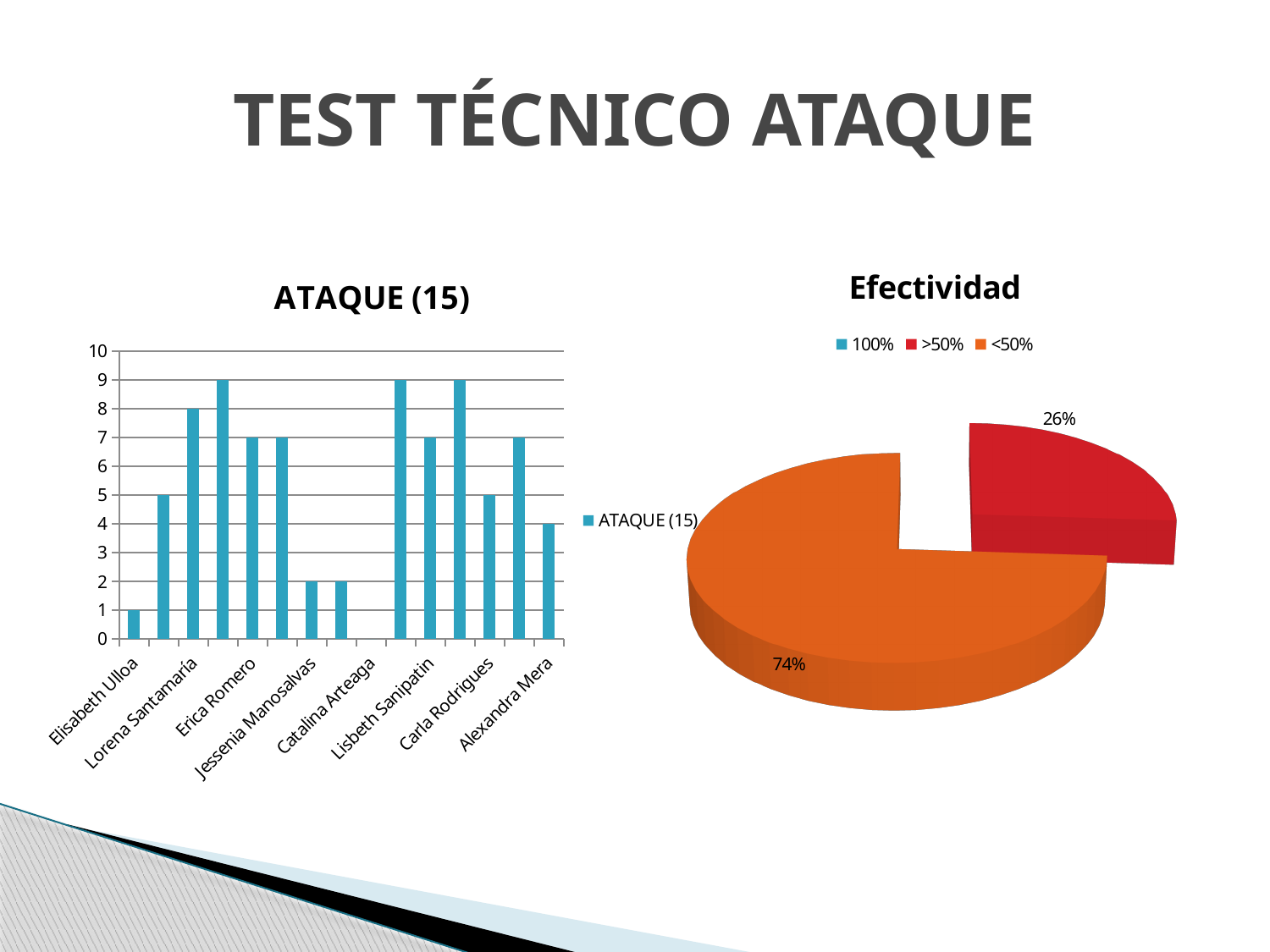
How many entries does the legend of the 'Efectividad' pie chart list? 3 In the 'ATAQUE (15)' chart, what is the difference between the values for Lorena Santamaría and Jessenia Manosalvas? 6 In the 'Efectividad' pie chart, what share does the '>50%' slice have? 26% In the 'ATAQUE (15)' chart, what is the value for Elisabeth Ulloa? 1 In the 'ATAQUE (15)' chart, what is the value for Alexandra Mera? 4 In the 'ATAQUE (15)' chart, what is the value for Lorena Santamaría? 8 In the 'ATAQUE (15)' chart, is the value for Lisbeth Sanipatin greater or less than 5? greater In the 'Efectividad' pie chart, what share does the '<50%' slice have? 74% What kind of chart is the 'ATAQUE (15)' chart on the left? bar chart In the 'ATAQUE (15)' chart, what is the value for Catalina Arteaga? 0 What kind of chart is the 'Efectividad' chart on the right? pie chart In the 'ATAQUE (15)' chart, who has the larger value, Erica Romero or Carla Rodrigues? Erica Romero